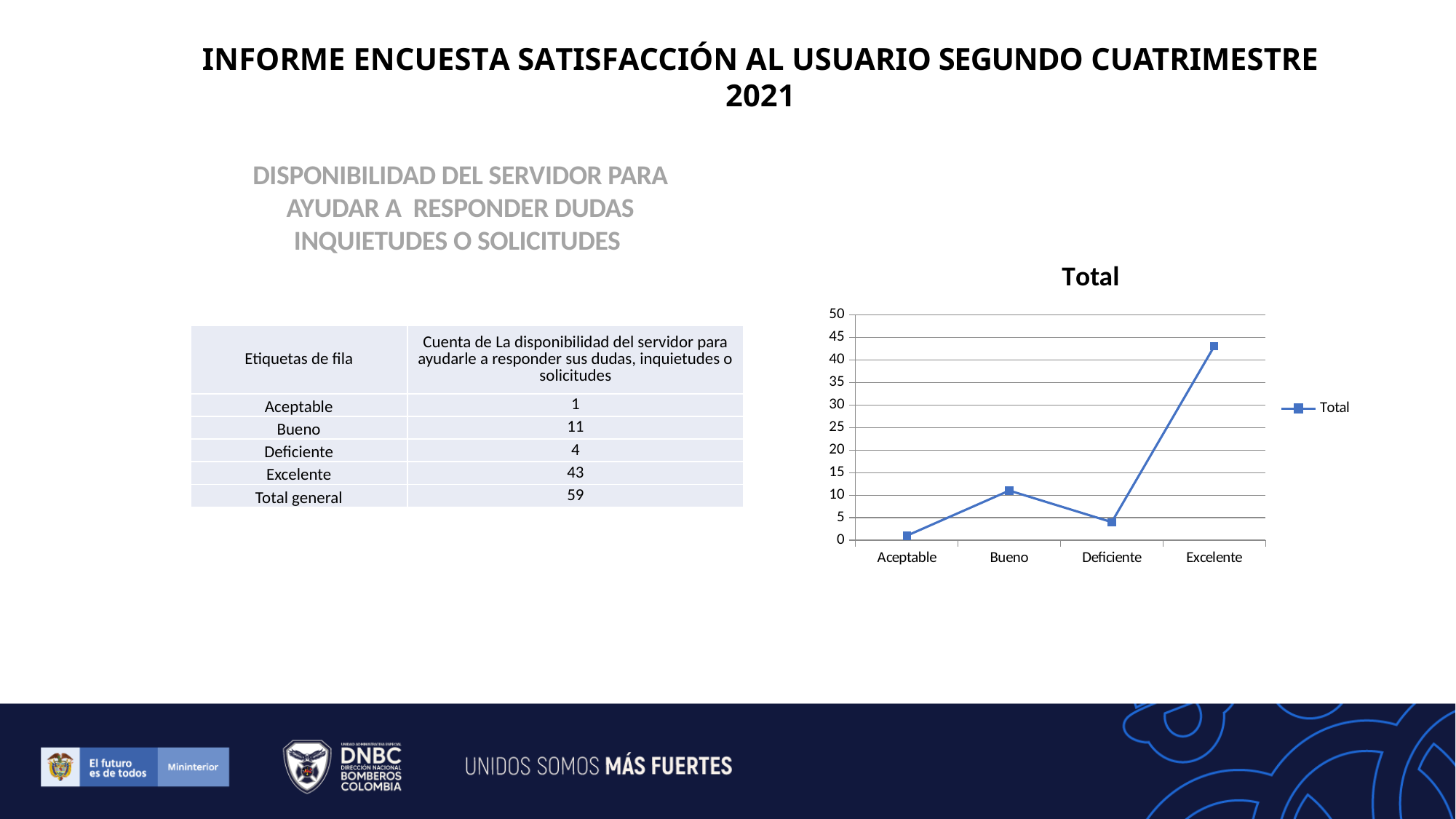
What is the value for Excelente in the "Total" chart? 43 In the "Total" chart, which is larger, the value for Bueno or the value for Deficiente? Bueno What is the value for Bueno in the "Total" chart? 11 What kind of chart is the "Total" chart on the slide? line chart What is the value for Deficiente in the "Total" chart? 4 What is the difference between the values for Excelente and Bueno in the "Total" chart? 32 In the "Total" chart, is the value for Deficiente greater or less than 5? less How many categories are shown on the x axis of the "Total" chart? 4 In the "Total" chart, is the value for Excelente greater or less than 40? greater How many series does the legend of the "Total" chart list? 1 Which category has the highest value in the "Total" chart? Excelente Which category has the lowest value in the "Total" chart? Aceptable